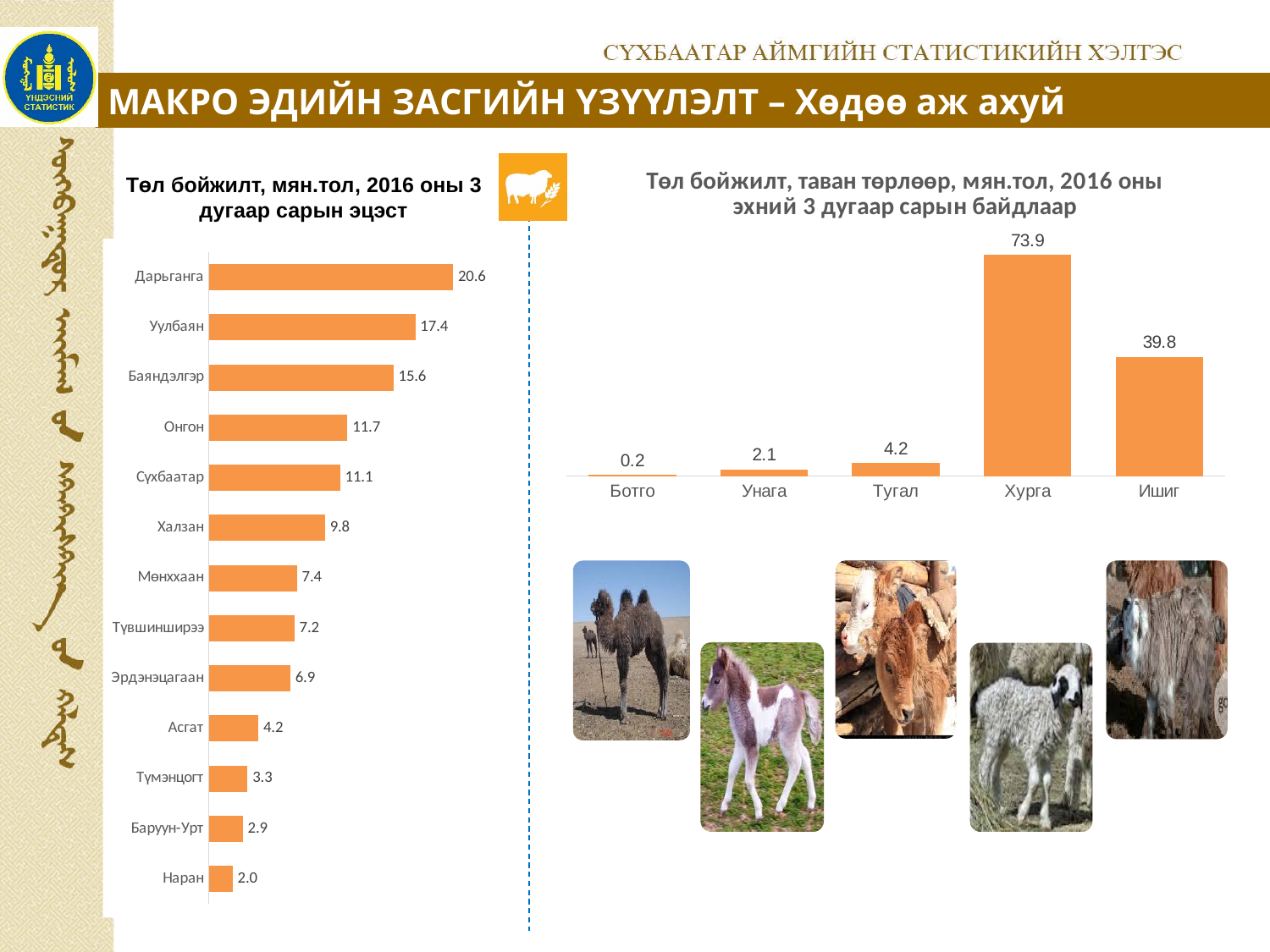
In the left chart (Төл бойжилт, мян.тол, 2016 оны 3 дугаар сарын эцэст), what is the value for Дарьганга? 20.6 In the left chart, which category has the highest value? Дарьганга In the right chart (Төл бойжилт, таван төрлөөр), what is the value for Хурга? 73.9 In the left chart, how many categories are shown? 13 In the left chart, which is larger, the value for Халзан or the value for Мөнххаан? Халзан In the right chart, how many categories are shown? 5 In the right chart, what is the difference between the values for Хурга and Ишиг? 34.1 In the left chart, which category has the lowest value? Наран In the left chart, what is the value for Онгон? 11.7 In the right chart, what is the value for Ботго? 0.2 In the left chart, what is the difference between the values for Уулбаян and Баяндэлгэр? 1.8 What type of chart is the right chart? Bar chart